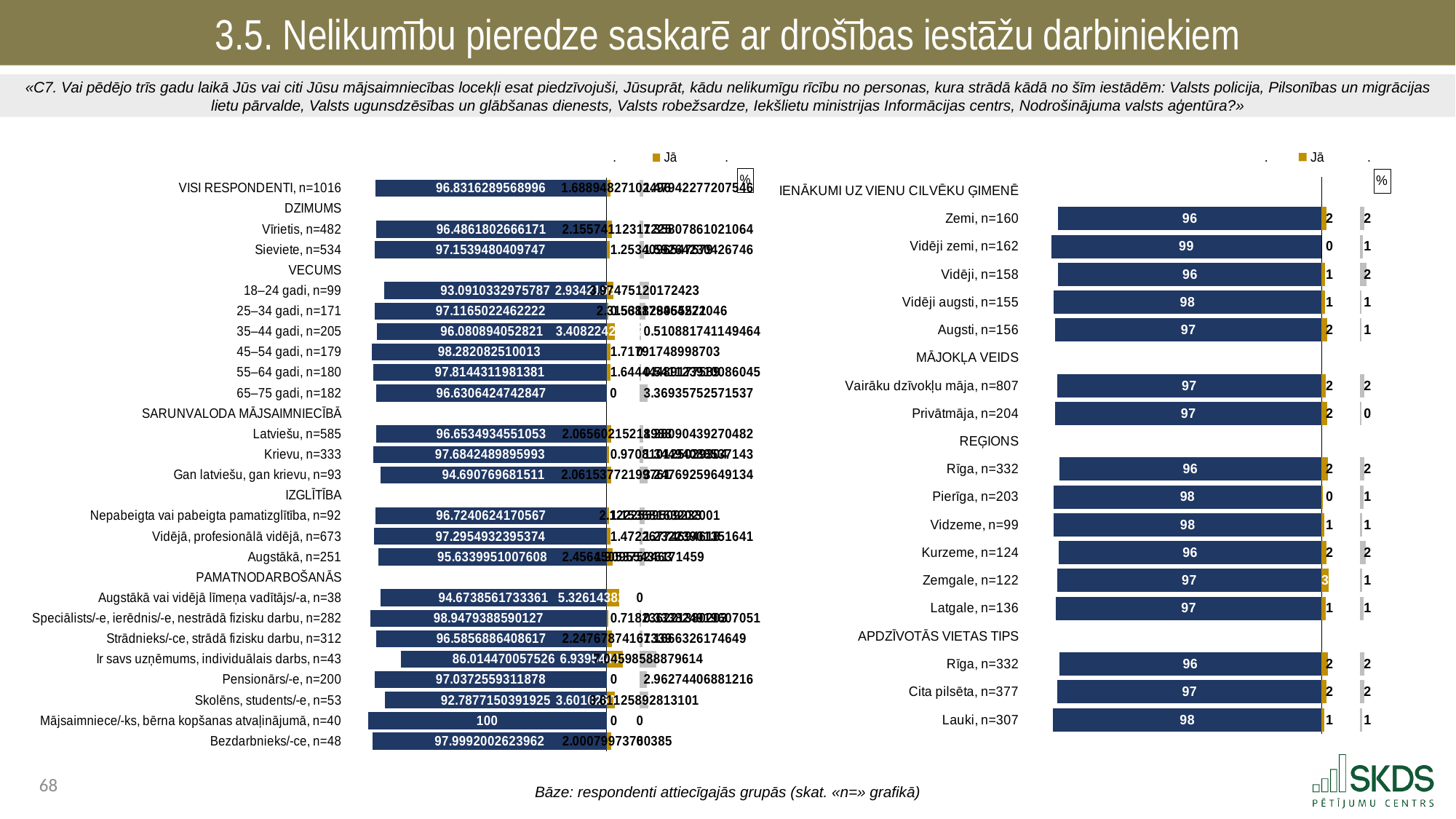
In the right chart, what is the total of the three segments for 'Privātmāja, n=204'? 99 In the left chart, what is the value of the dark blue segment for '45–54 gadi, n=179'? 98.282082510013 In the right chart, what is the 'Jā' value for 'Zemgale, n=122'? 3 In the left chart, which group has the lowest dark blue segment value? Ir savs uzņēmums, individuālais darbs, n=43 In the left chart, what is the value of the dark blue segment for 'Mājsaimniece/-ks, bērna kopšanas atvaļinājumā, n=40'? 100 In the right chart, what is the total of the three segments for 'Zemi, n=160'? 100 In the right chart, how many regions are listed under 'REĢIONS'? 6 In the right chart, which income group under 'IENĀKUMI UZ VIENU CILVĒKU ĢIMENĒ' has the highest dark blue segment value? Vidēji zemi, n=162 In the right chart, is the dark blue segment value larger for 'Lauki, n=307' or for 'Rīga, n=332' under 'APDZĪVOTĀS VIETAS TIPS'? Lauki, n=307 In the right chart, what is the 'Jā' value for 'Pierīga, n=203'? 0 In the right chart, what is the value of the first (dark blue) segment for 'Vidēji zemi, n=162'? 99 What type of chart is used on the left side of the slide? Bar chart